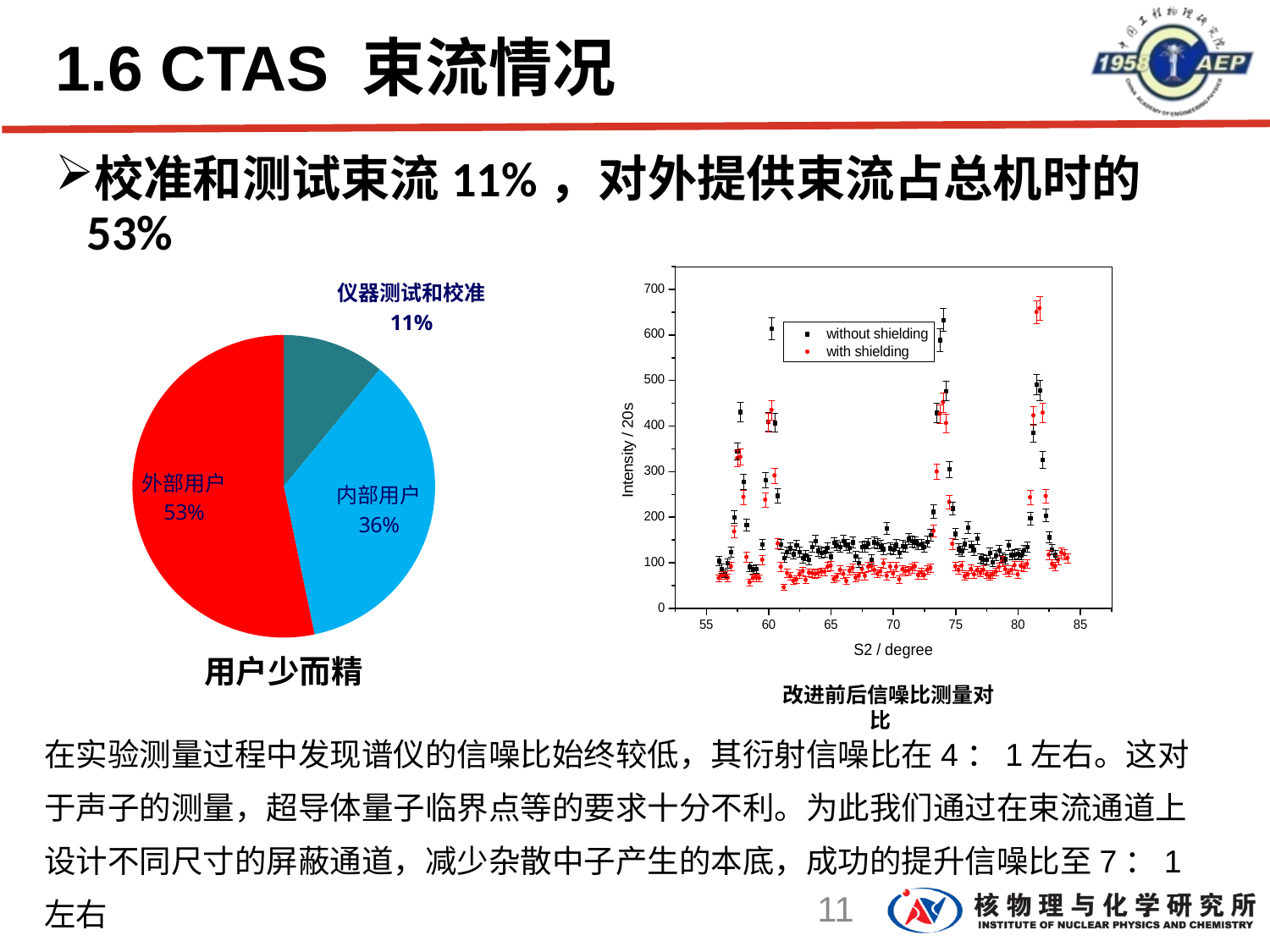
On the pie chart on the left, what share does 外部用户 have? 53% On the pie chart on the left, how many slices are there? 3 On the pie chart on the left, what share does 内部用户 have? 36% On the pie chart on the left, which slice is the largest? 外部用户 On the scatter plot on the right, which series is plotted in red? with shielding On the pie chart on the left, which slice is the smallest? 仪器测试和校准 On the scatter plot on the right, how many series does the legend list? 2 On the pie chart on the left, what share does 仪器测试和校准 have? 11% On the scatter plot on the right, what is the label of the x axis? S2 / degree What kind of chart is the chart on the right of the slide? scatter plot What kind of chart is the chart on the left of the slide? pie chart On the pie chart on the left, what is the difference in percentage points between 外部用户 and 内部用户? 17